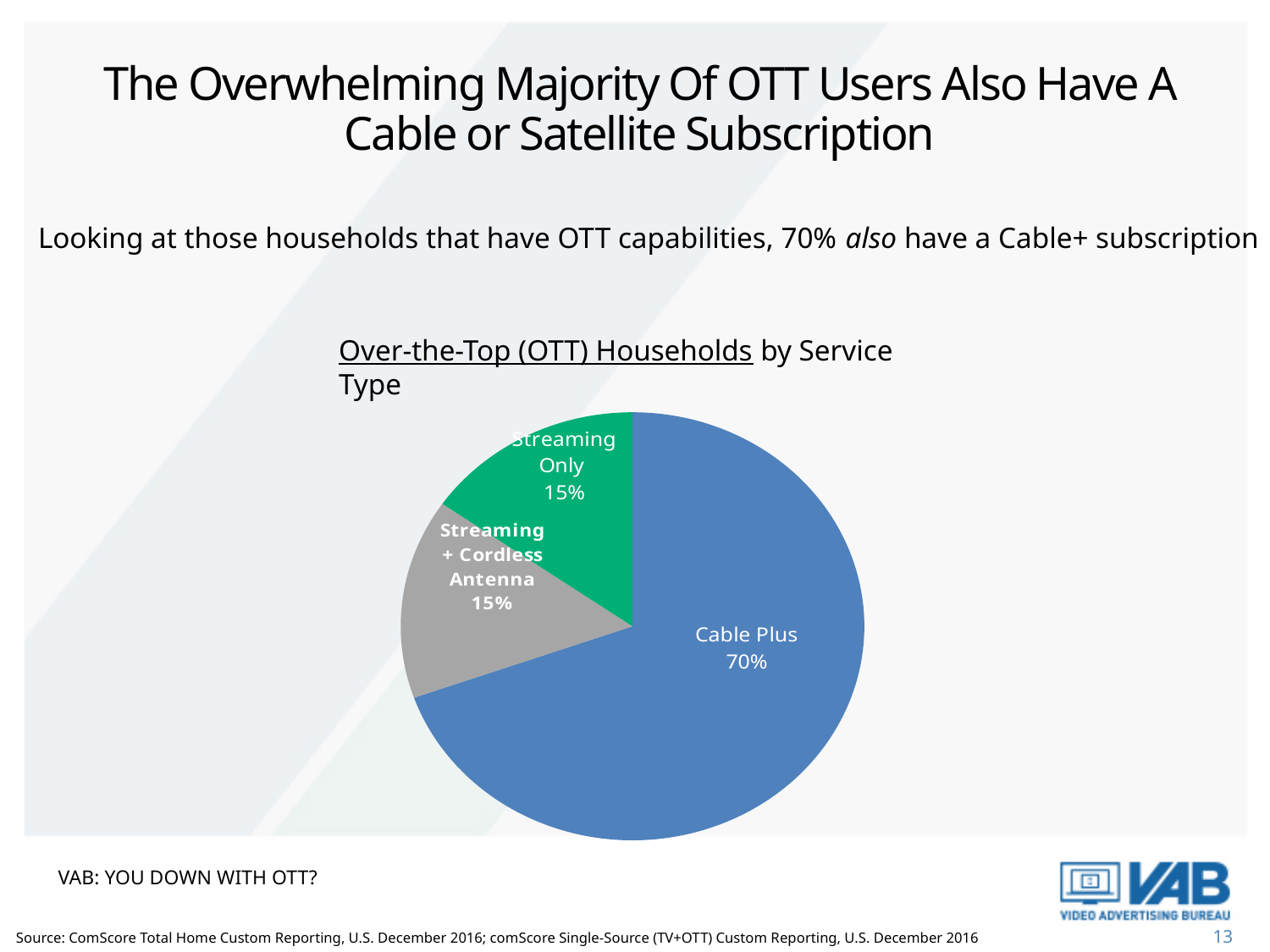
What is the difference in share between Cable Plus and Streaming Only? 55% How many service types are shown in the pie chart? 3 What is the combined share of Streaming Only and Streaming + Cordless Antenna households? 30% What colour is the Cable Plus slice? Blue Which service type has the largest share of OTT households? Cable Plus What kind of chart is shown on the slide? Pie chart What is the title of the chart? Over-the-Top (OTT) Households by Service Type What share of OTT households are Streaming Only? 15% What share of OTT households are Streaming + Cordless Antenna? 15% What share of OTT households are Cable Plus? 70% Which is larger, the Cable Plus share or the Streaming + Cordless Antenna share? Cable Plus